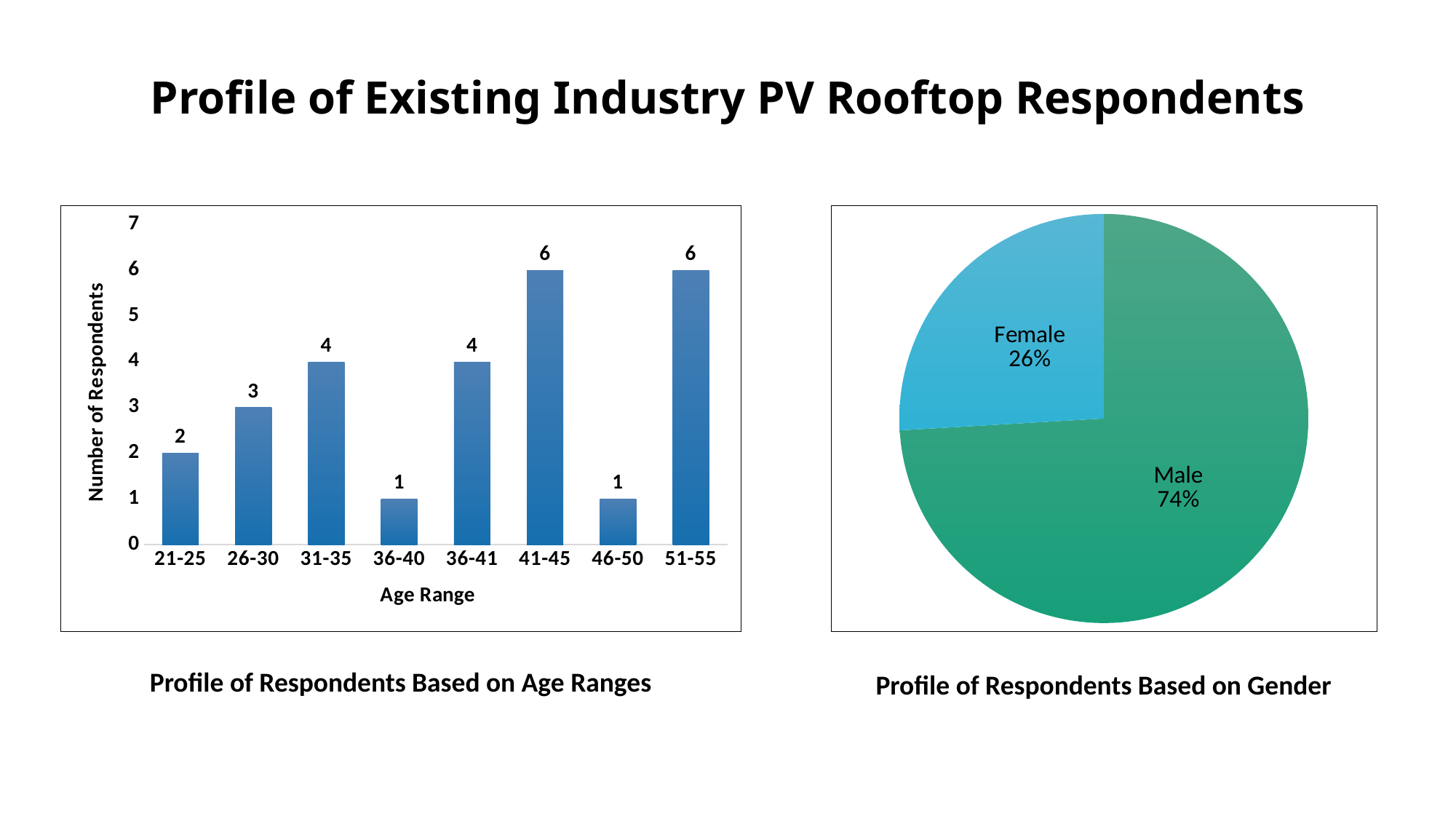
In the 'Profile of Respondents Based on Age Ranges' chart, which has more respondents, 31-35 or 26-30? 31-35 In the 'Profile of Respondents Based on Age Ranges' chart, which age range has the fewest respondents? 36-40 and 46-50 In the 'Profile of Respondents Based on Age Ranges' chart, how many respondents are in the 26-30 age range? 3 In the 'Profile of Respondents Based on Age Ranges' chart, how many respondents are in the 36-40 age range? 1 In the 'Profile of Respondents Based on Gender' chart, what share of respondents are Male? 74% What type of chart is 'Profile of Respondents Based on Gender'? Pie chart In the 'Profile of Respondents Based on Gender' chart, what share of respondents are Female? 26% What is the label of the y-axis in the 'Profile of Respondents Based on Age Ranges' chart? Number of Respondents How many age range categories are shown in the 'Profile of Respondents Based on Age Ranges' chart? 8 In the 'Profile of Respondents Based on Age Ranges' chart, how many respondents are in the 21-25 age range? 2 What type of chart is 'Profile of Respondents Based on Age Ranges'? Bar chart In the 'Profile of Respondents Based on Age Ranges' chart, what is the difference in respondents between the 41-45 and 21-25 age ranges? 4